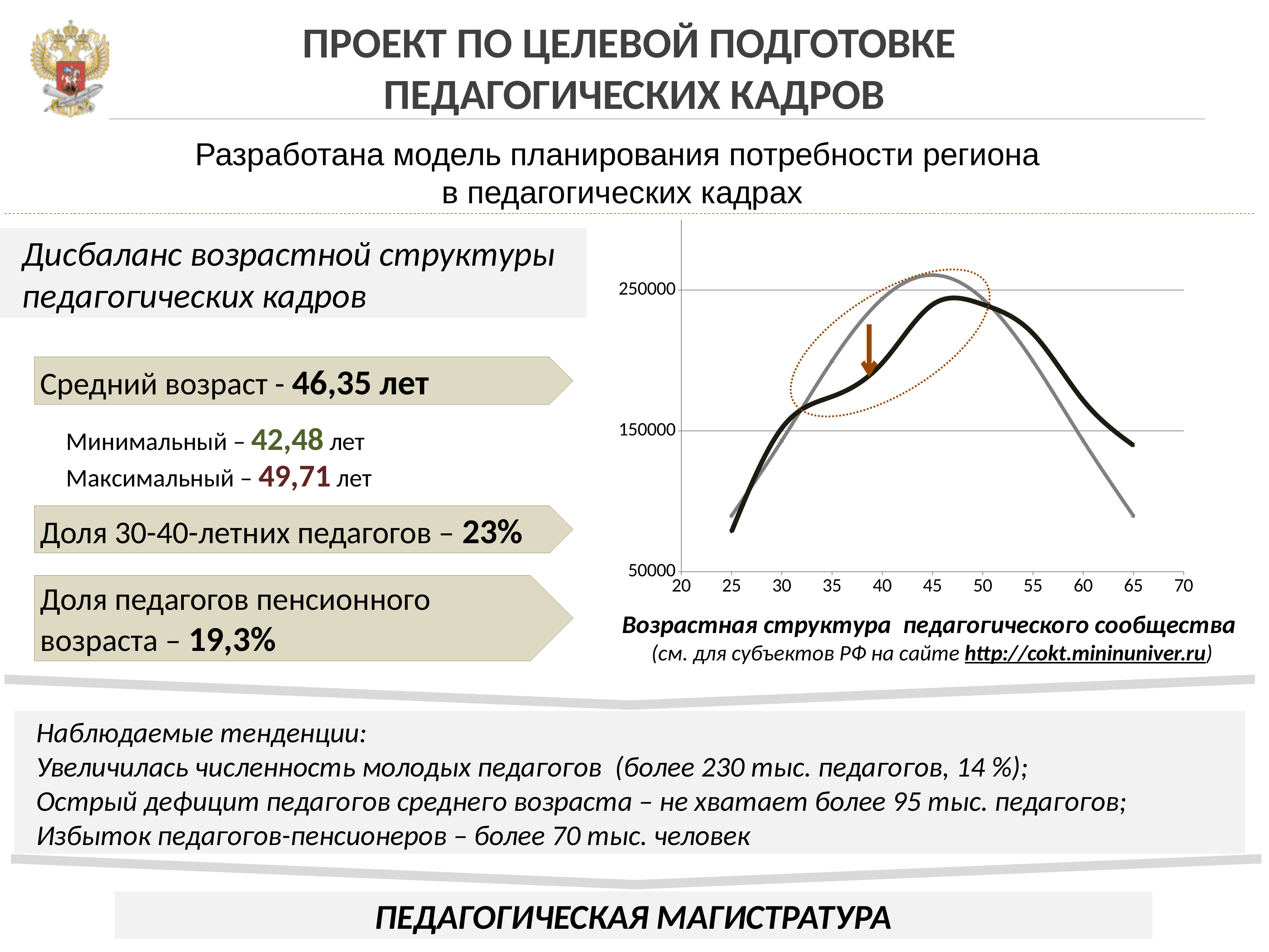
Which line reaches the higher peak value, the grey line or the black line? the grey line How many lines are plotted on the chart? 2 Is the value of the grey line at age 65 greater or less than 150000? less Does the grey line rise or fall between age 50 and age 65? fall What kind of chart is shown on the right side of the slide? line chart Does the black line rise or fall between age 25 and age 45? rise What is the title printed under the chart? Возрастная структура педагогического сообщества Is the value of the black line at age 55 greater or less than 150000? greater What is the highest value labelled on the vertical axis of the chart? 250000 Is the value of the grey line at age 45 greater or less than 250000? greater